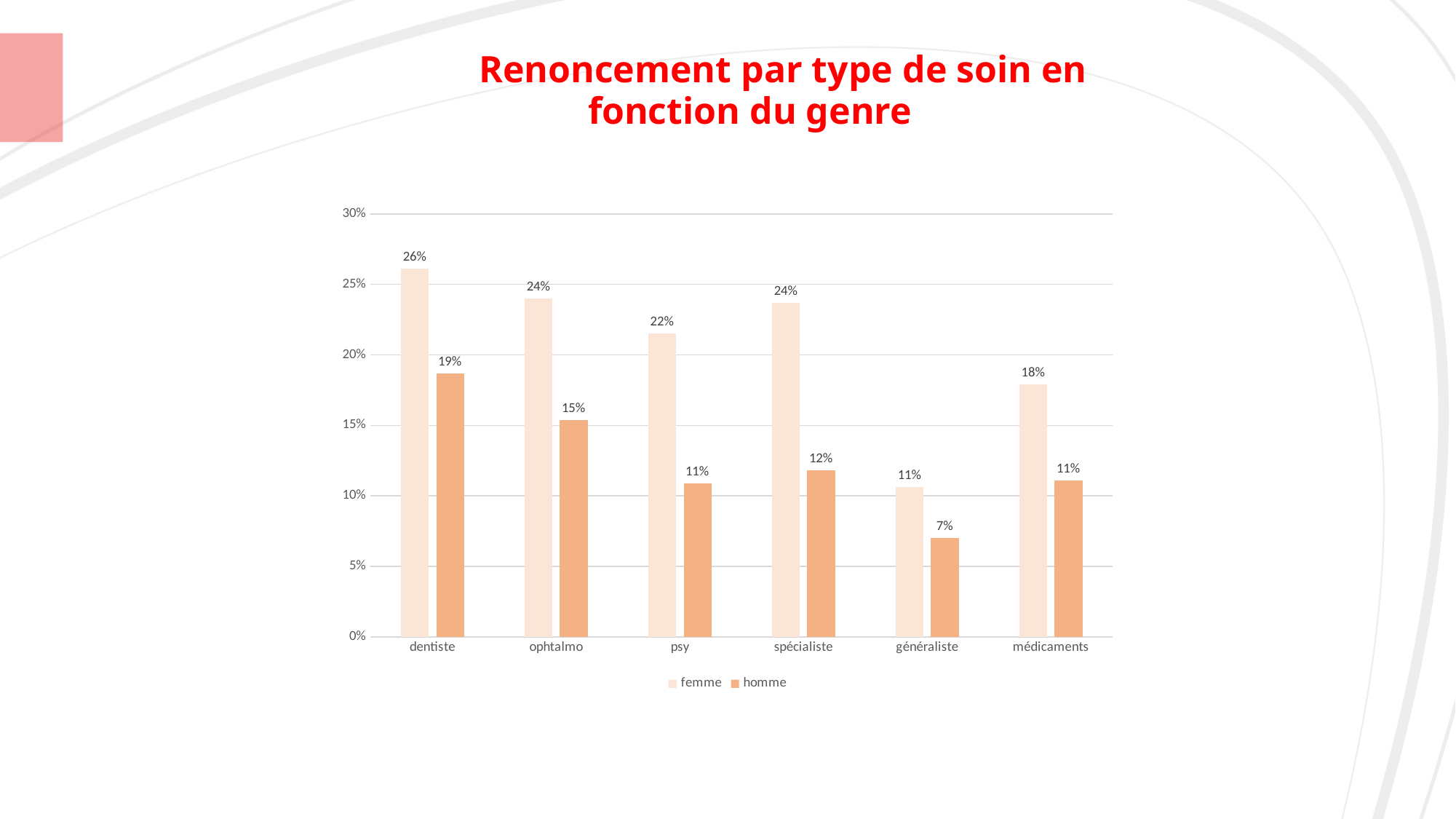
How many categories are shown on the x axis? 6 What is the value for homme in the ophtalmo category? 15% What is the difference between the femme and homme values in the dentiste category? 7% Which is larger: the homme value for ophtalmo or the homme value for spécialiste? ophtalmo What is the value for homme in the généraliste category? 7% How many series does the legend list? 2 Which category has the highest value for the femme series? dentiste What is the title of the chart? Renoncement par type de soin en fonction du genre What kind of chart is shown on the slide? bar chart Which category has the lowest value for the homme series? généraliste What is the value for femme in the dentiste category? 26% Is the femme value for psy greater or less than 20%? greater